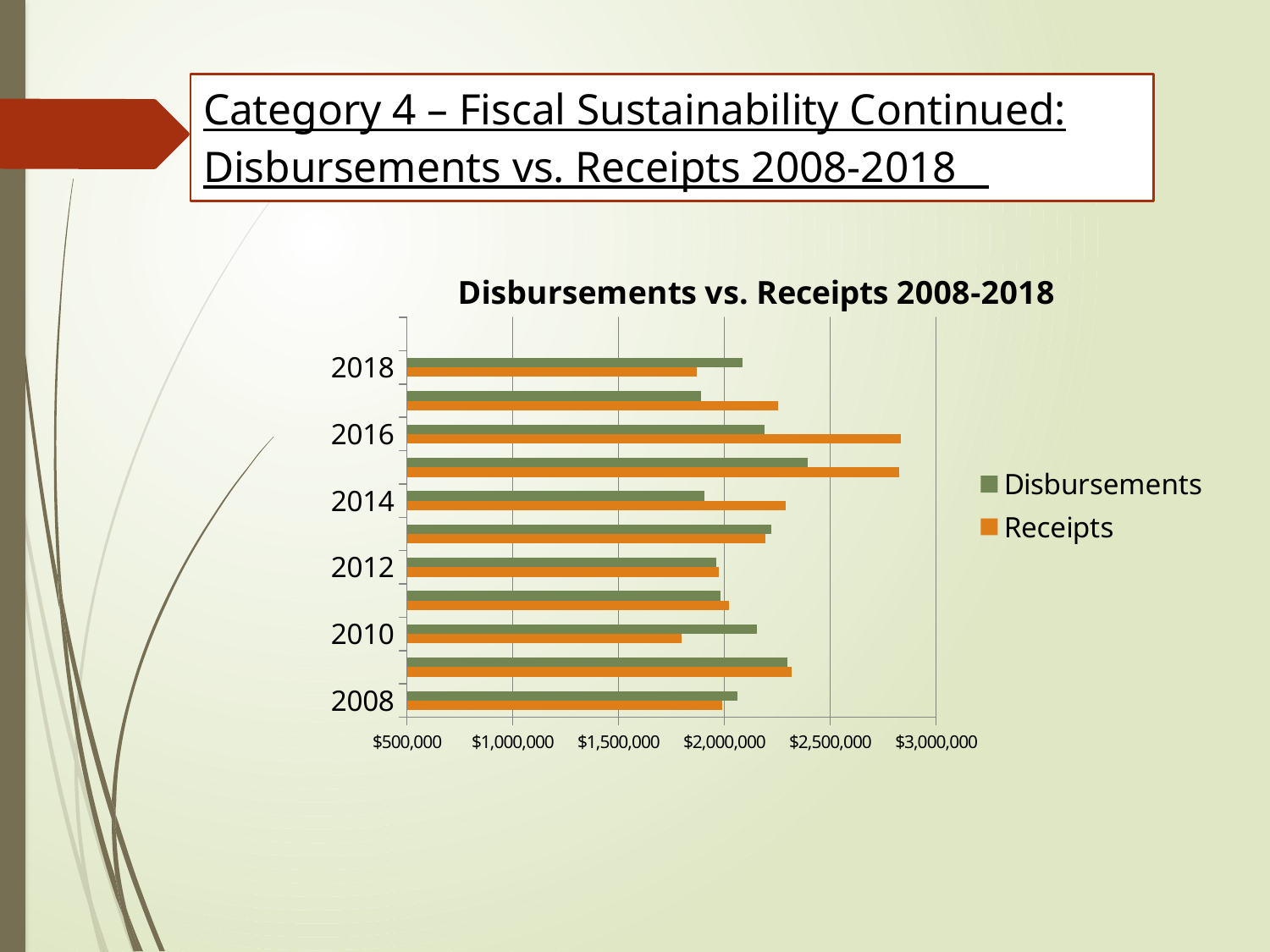
Is the value for Disbursements in 2015 greater or less than $2,500,000? less How many series does the legend list? 2 In 2016, which is larger, Disbursements or Receipts? Receipts How many years are plotted on the chart? 11 Is the value for Disbursements in 2017 greater or less than $2,000,000? less What is the title of the chart? Disbursements vs. Receipts 2008-2018 Is the value for Receipts in 2016 greater or less than $2,500,000? greater In 2014, which is larger, Disbursements or Receipts? Receipts What kind of chart is shown on the slide? Bar chart Which series is shown in orange? Receipts In 2010, which is larger, Disbursements or Receipts? Disbursements